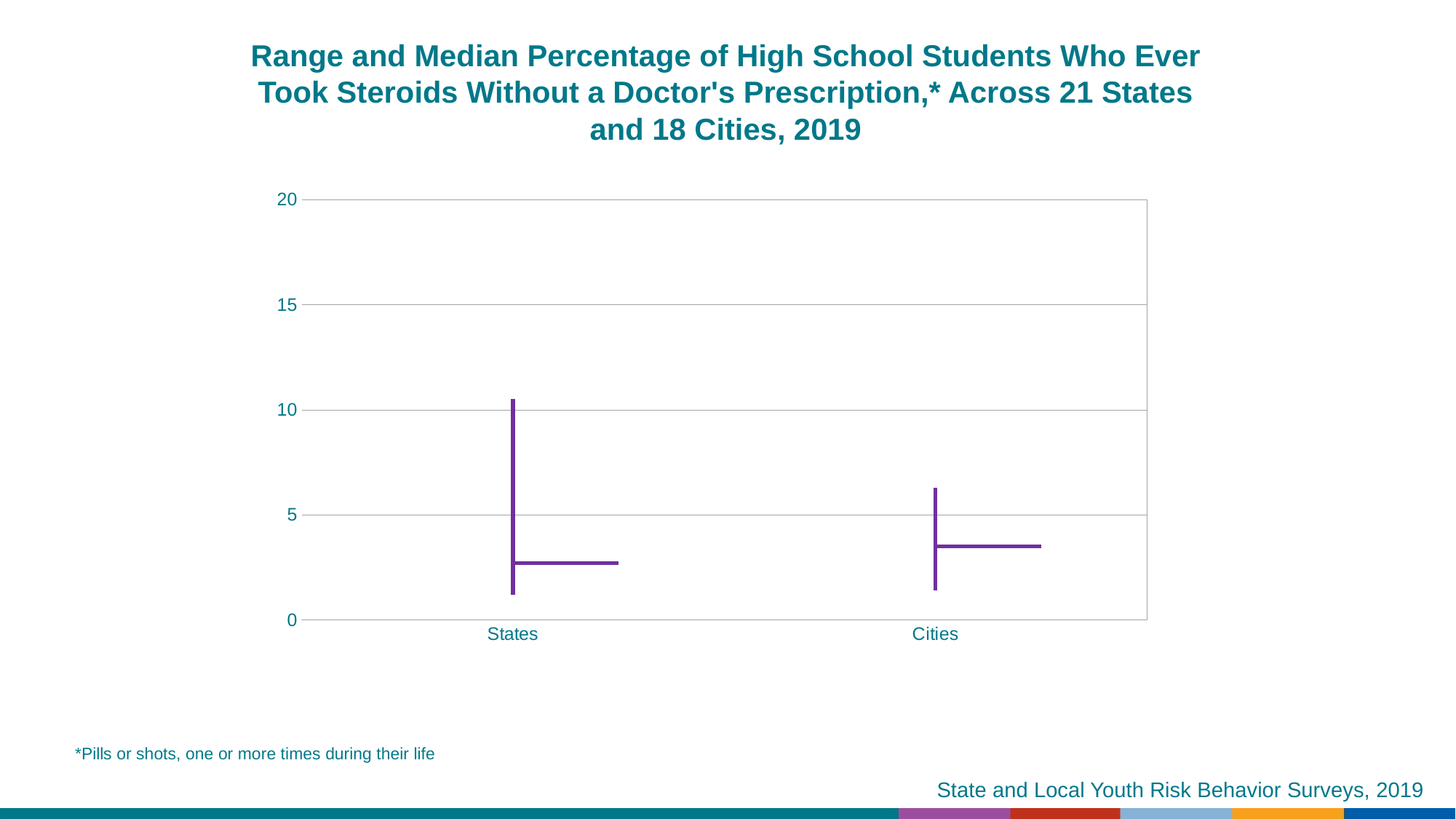
Is the bottom of the range for Cities greater or less than 5? less What is the highest value shown on the y axis? 20 What are the two categories shown on the x axis? States and Cities Is the top of the range for Cities greater or less than 10? less Which category has the higher median value, States or Cities? Cities Is the median value for States greater or less than 5? less How many categories are shown on the x axis of the chart? 2 Which category has the lower median value? States Which category shows the wider range of values? States Which category has the higher maximum value in its range, States or Cities? States